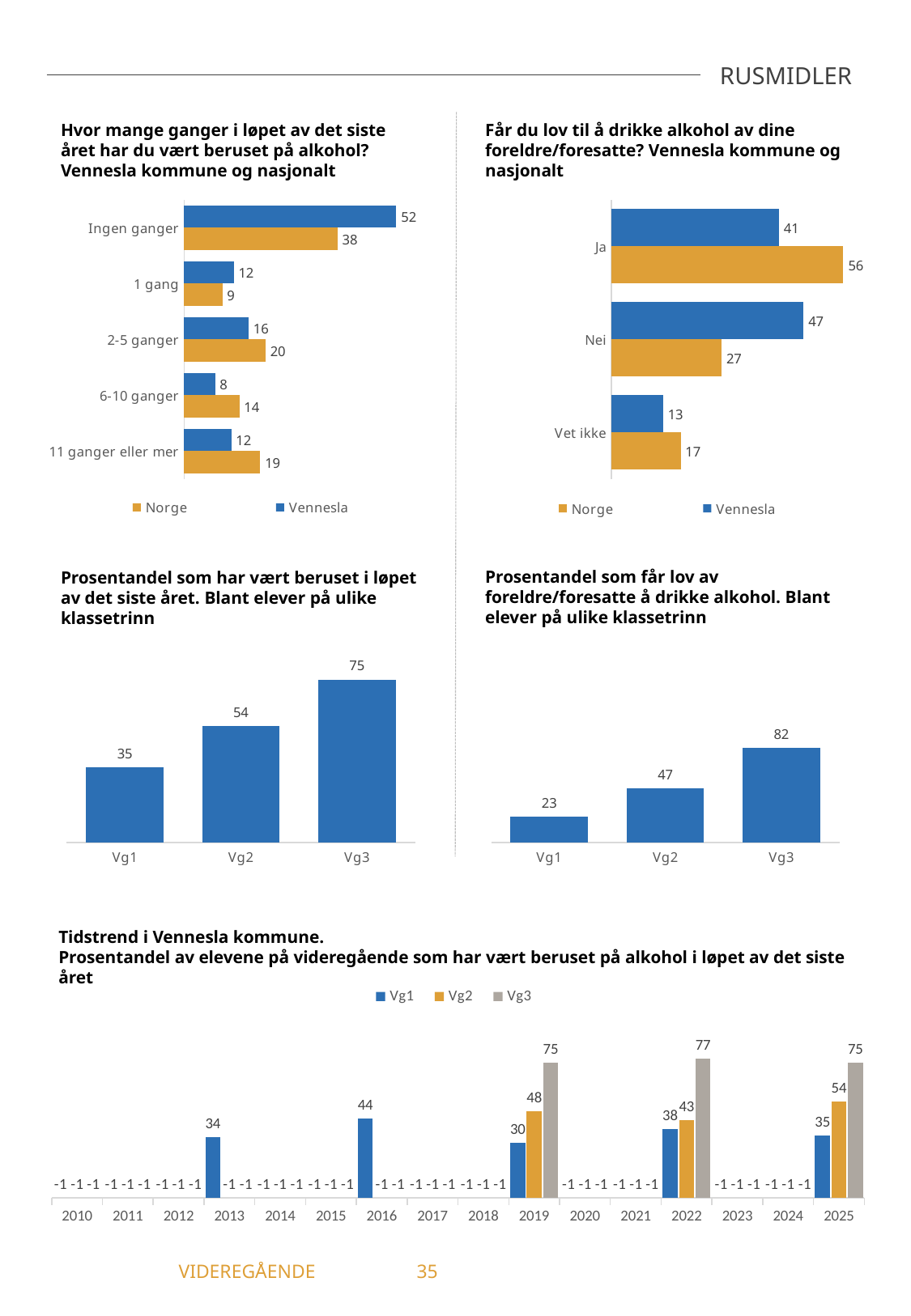
In the chart 'Får du lov til å drikke alkohol av dine foreldre/foresatte?', which is larger for 'Nei': Norge or Vennesla? Vennesla In the chart 'Tidstrend i Vennesla kommune', what is the value for Vg3 in 2022? 77 In the chart 'Får du lov til å drikke alkohol av dine foreldre/foresatte?', what is the value for Norge for 'Ja'? 56 In the chart 'Prosentandel som får lov av foreldre/foresatte å drikke alkohol. Blant elever på ulike klassetrinn', what is the difference between Vg3 and Vg1? 59 In the chart 'Prosentandel som har vært beruset i løpet av det siste året. Blant elever på ulike klassetrinn', which class level has the highest value? Vg3 In the chart 'Får du lov til å drikke alkohol av dine foreldre/foresatte?', how many series does the legend list? 2 What kind of chart is 'Tidstrend i Vennesla kommune'? bar chart In the chart 'Prosentandel som har vært beruset i løpet av det siste året. Blant elever på ulike klassetrinn', what is the value for Vg2? 54 In the chart 'Hvor mange ganger i løpet av det siste året har du vært beruset på alkohol?', what is the value for Vennesla for 'Ingen ganger'? 52 In the chart 'Hvor mange ganger i løpet av det siste året har du vært beruset på alkohol?', how many categories are shown? 5 In the chart 'Hvor mange ganger i løpet av det siste året har du vært beruset på alkohol?', what is the difference between the Norge and Vennesla values for '11 ganger eller mer'? 7 In the chart 'Prosentandel som får lov av foreldre/foresatte å drikke alkohol. Blant elever på ulike klassetrinn', do the values rise or fall from Vg1 to Vg3? rise